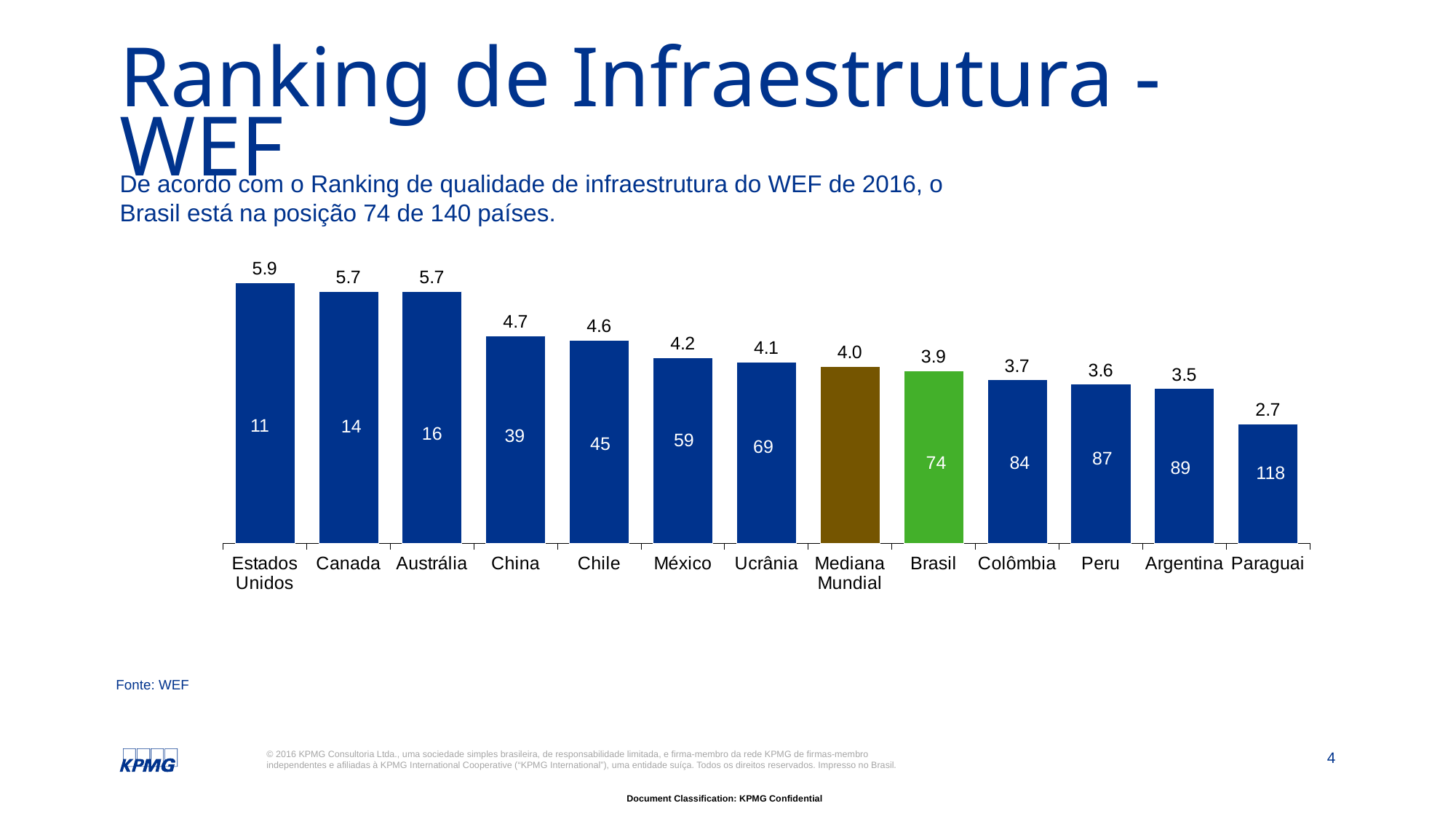
What ranking position is printed inside the bar for Brasil? 74 What kind of chart is shown on the slide? Bar chart What score is shown above the bar for Brasil? 3.9 What is the difference between the score for Estados Unidos and the score for Brasil? 2.0 Which has a higher score, Chile or México? Chile Which category has the lowest score in the chart? Paraguai Do the scores rise or fall from left to right across the chart? Fall What score is shown for Mediana Mundial? 4.0 What colour is the bar for Brasil? Green How many bars are shown in the chart? 13 What ranking position is printed inside the bar for Paraguai? 118 Which category has the highest score in the chart? Estados Unidos